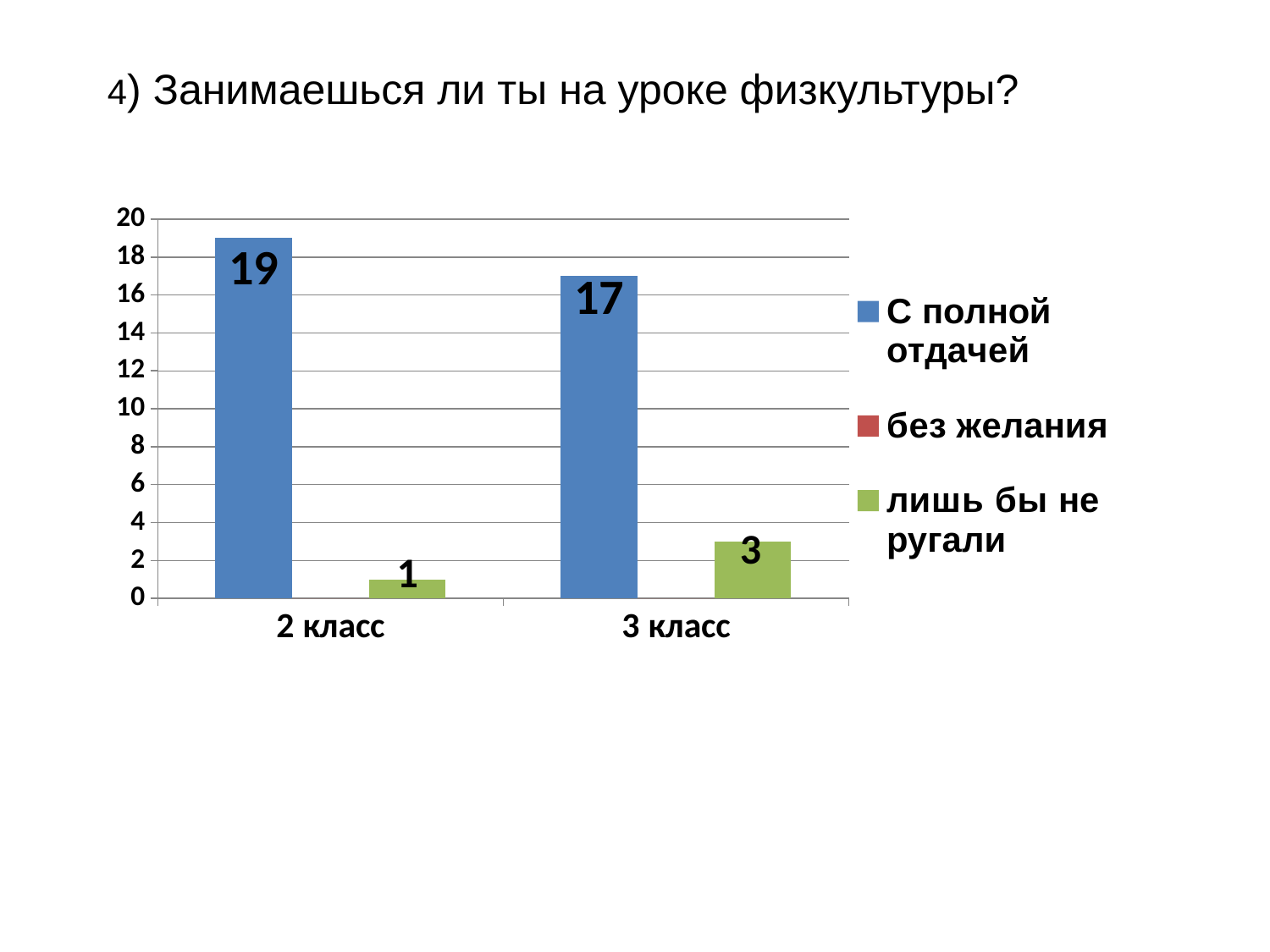
What is the value for 'лишь бы не ругали' in 2 класс? 1 What is the value for 'С полной отдачей' in 2 класс? 19 How many categories are shown on the x axis? 2 Which is larger: 'лишь бы не ругали' in 3 класс or 'лишь бы не ругали' in 2 класс? 3 класс How many series does the legend list? 3 What is the value for 'лишь бы не ругали' in 3 класс? 3 Which class has the higher value for 'С полной отдачей'? 2 класс What is the value for 'С полной отдачей' in 3 класс? 17 What kind of chart is shown on the slide? Bar chart Which class has the lower value for 'лишь бы не ругали'? 2 класс What is the difference between 'С полной отдачей' and 'лишь бы не ругали' in 3 класс? 14 What is the difference between the 'С полной отдачей' values for 2 класс and 3 класс? 2